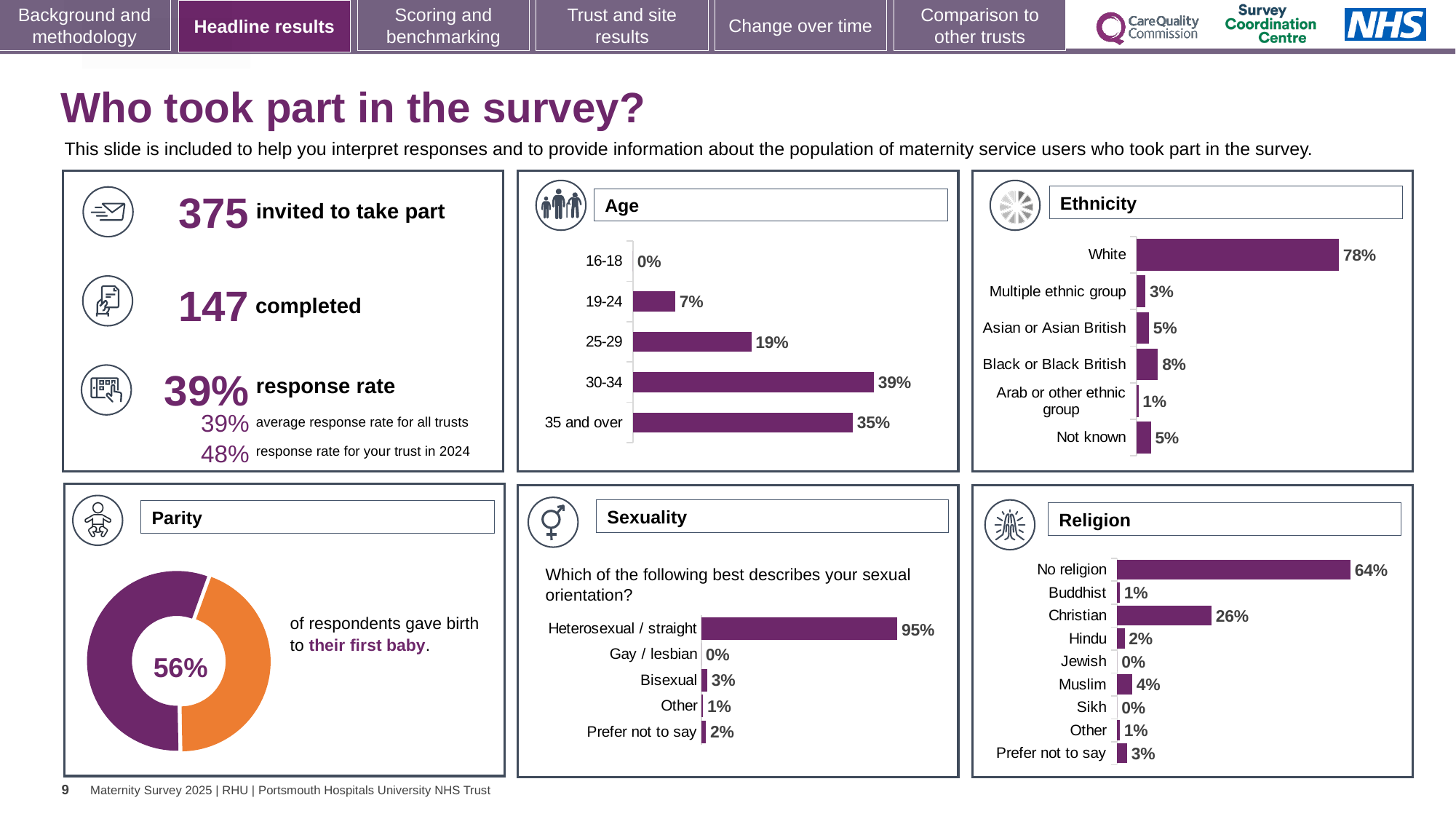
In the Parity chart, what share of respondents gave birth to their first baby? 56% In the Ethnicity chart, what is the difference between the percentages for White and Black or Black British? 70% What kind of chart is the Parity chart? Doughnut chart In the Religion chart, what percentage of respondents were Christian? 26% In the Age chart, what percentage of respondents were aged 30-34? 39% In the Ethnicity chart, what percentage of respondents were White? 78% How many categories are shown in the Ethnicity chart? 6 In the Religion chart, which category has the highest percentage? No religion How many categories are shown in the Religion chart? 9 In the Sexuality chart, what percentage of respondents answered Heterosexual / straight? 95% In the Religion chart, which is larger, the percentage for Muslim or the percentage for Hindu? Muslim In the Age chart, which age group has the highest percentage? 30-34